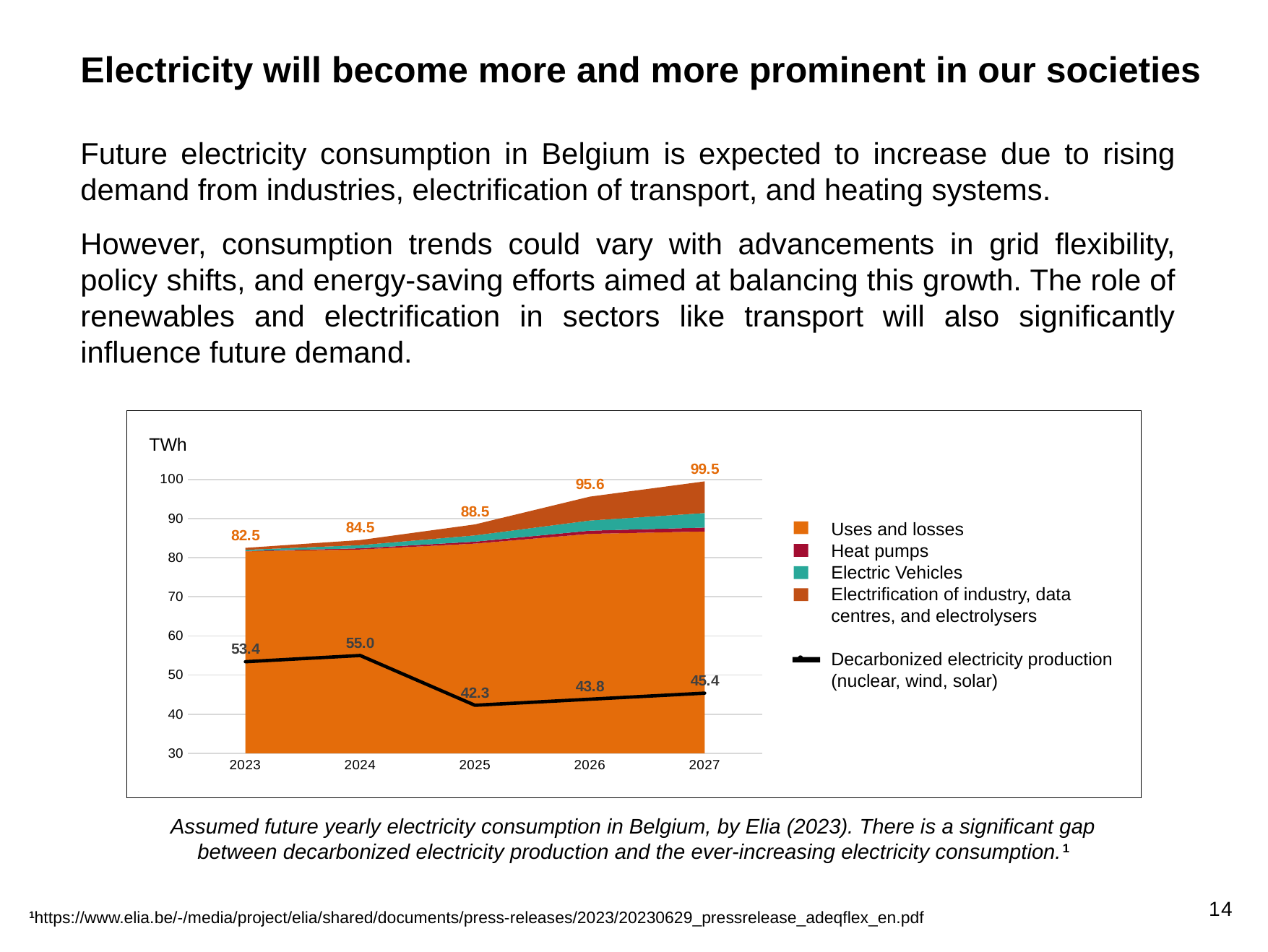
How many years are shown on the x axis? 5 What is the decarbonized electricity production value shown for 2025? 42.3 Which is larger, decarbonized production in 2023 or in 2026? 2023 What is the difference between total consumption and decarbonized production in 2027? 54.1 What is the total electricity consumption value shown for 2027? 99.5 Does total electricity consumption rise or fall from 2023 to 2027? rise In which year is decarbonized electricity production lowest? 2025 In which year is decarbonized electricity production highest? 2024 How many entries does the legend list? 5 What unit is shown on the y axis of the chart? TWh What is the total electricity consumption value shown for 2023? 82.5 By how much does total consumption increase from 2023 to 2027? 17.0